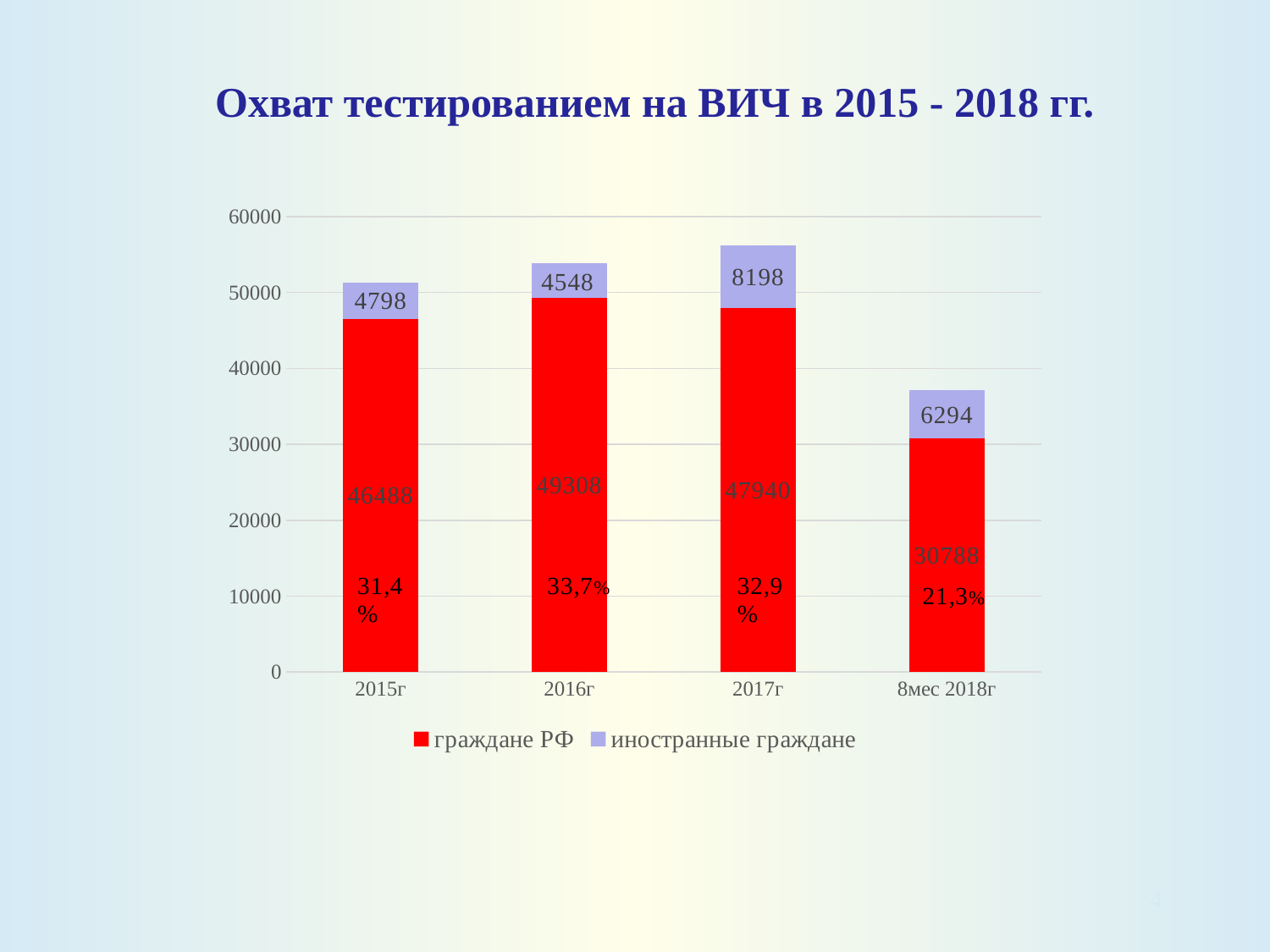
What is the value for иностранные граждане in 2017г? 8198 Which is larger: the иностранные граждане value for 2016г or for 8мес 2018г? 8мес 2018г What is the total of the stacked bar for 2017г? 56138 How many categories are shown on the x axis? 4 What is the difference between the граждане РФ values for 2016г and 2015г? 2820 What is the value for граждане РФ in 8мес 2018г? 30788 What is the value for иностранные граждане in 2015г? 4798 How many series does the legend list? 2 Which category has the lowest value for граждане РФ? 8мес 2018г What kind of chart is shown on the slide? Stacked bar chart Which category has the highest value for иностранные граждане? 2017г What is the value for граждане РФ in 2016г? 49308